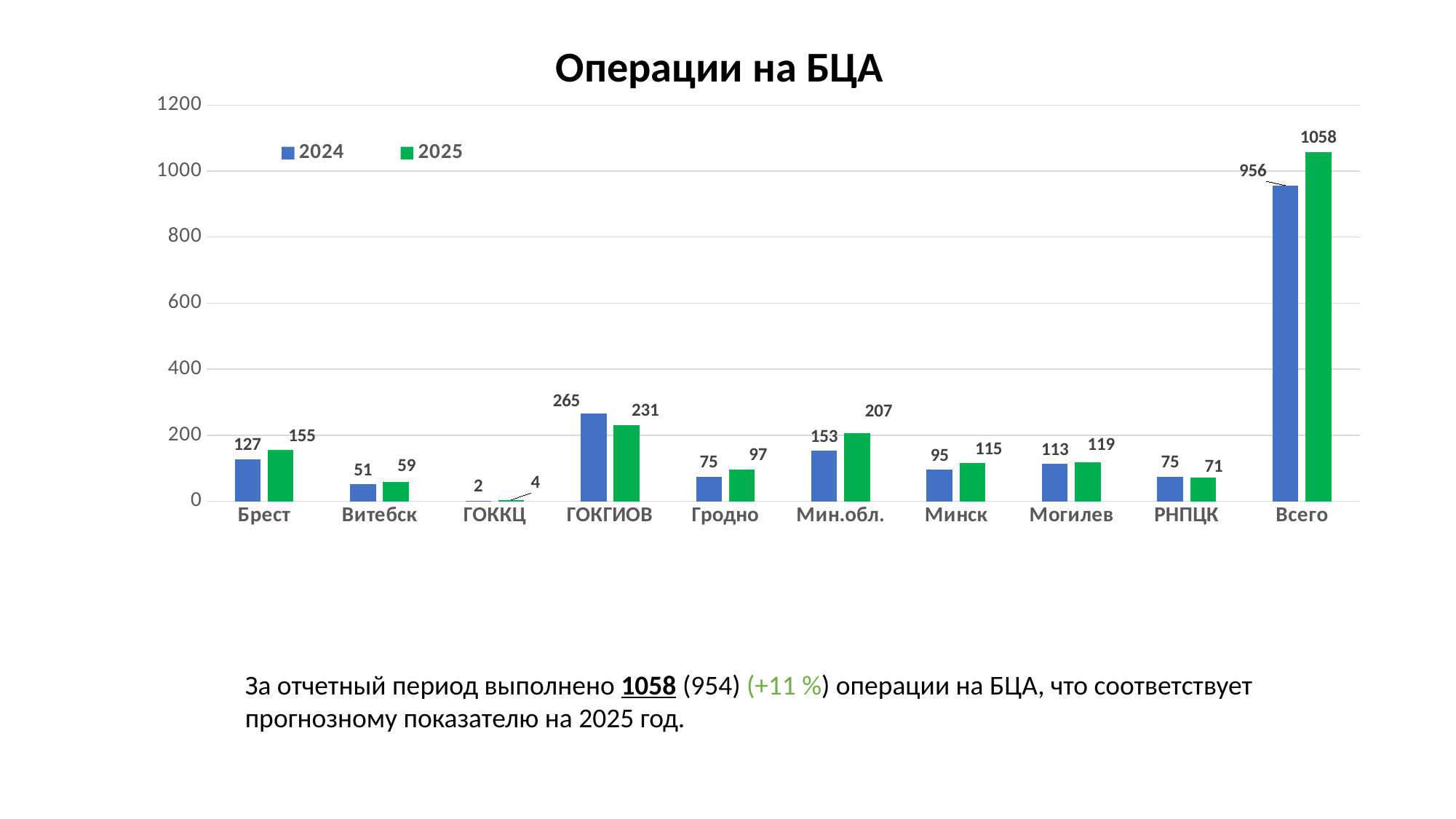
How many series does the legend list? 2 What type of chart is shown? bar chart What is the 2024 value for ГОКГИОВ? 265 Which category has the lowest 2024 value? ГОККЦ Excluding Всего, which category has the highest 2025 value? ГОКГИОВ Is the 2025 value for Всего greater or less than 1000? greater What is the 2024 value for Всего? 956 What is the 2025 value for Мин.обл.? 207 What is the difference between the 2025 and 2024 values for Всего? 102 What is the 2025 value for Брест? 155 Which is larger for РНПЦК: the 2024 value or the 2025 value? 2024 How many categories are shown on the x axis? 10